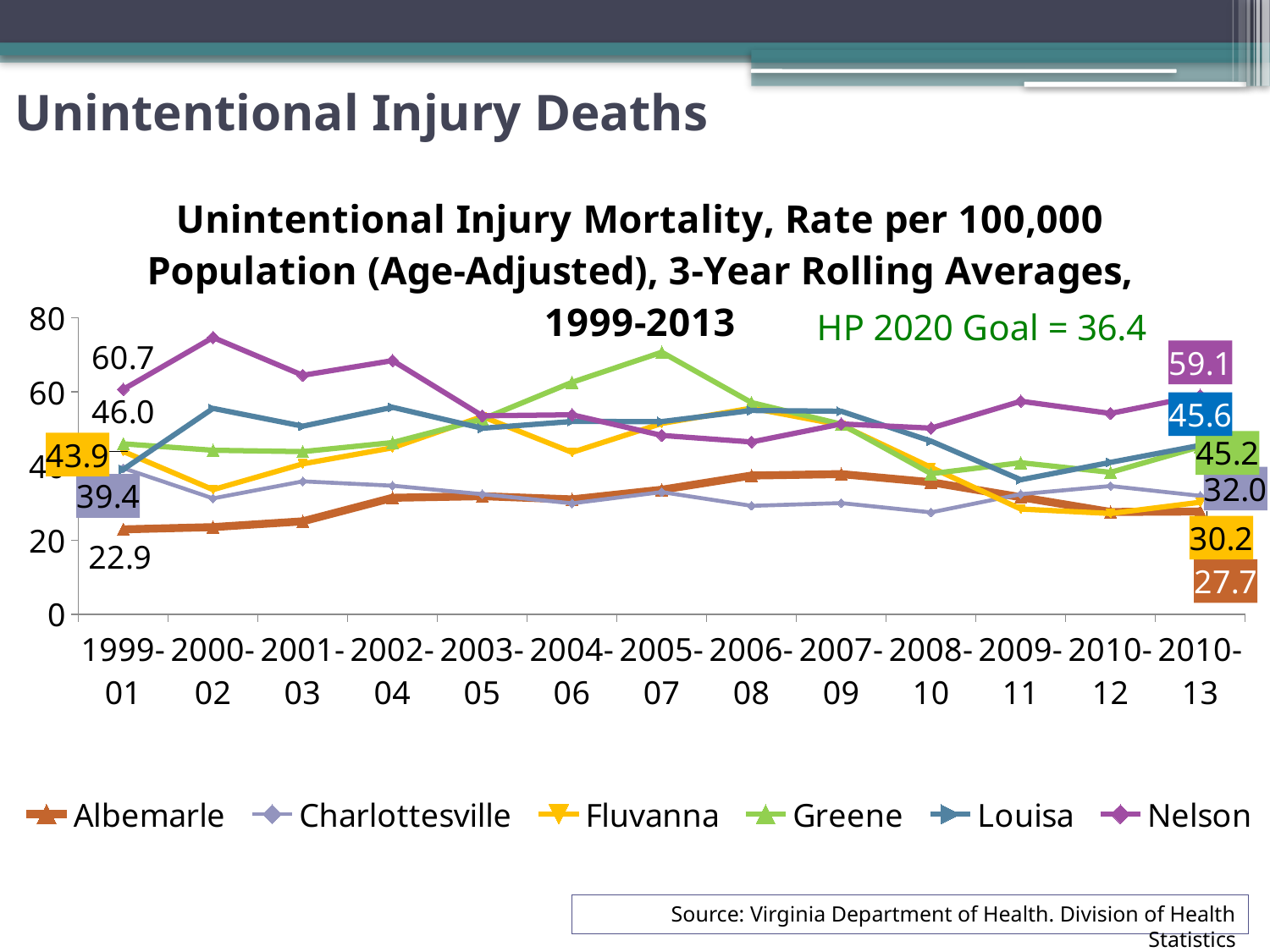
What kind of chart is shown on the slide? Line chart What is the unintentional injury mortality rate for Fluvanna in 2010-13? 30.2 Which locality has the highest rate in 2010-13? Nelson What is the unintentional injury mortality rate for Nelson in 1999-01? 60.7 What is the unintentional injury mortality rate for Albemarle in 1999-01? 22.9 How many time periods are shown along the x axis? 13 What is the unintentional injury mortality rate for Louisa in 2010-13? 45.6 Which locality has the lowest rate in 2010-13? Albemarle What is the HP 2020 Goal shown on the chart? 36.4 By how much did Albemarle's rate increase from 1999-01 to 2010-13? 4.8 How many series does the legend list? 6 Is the value for Greene in 2005-07 greater or less than 60? greater